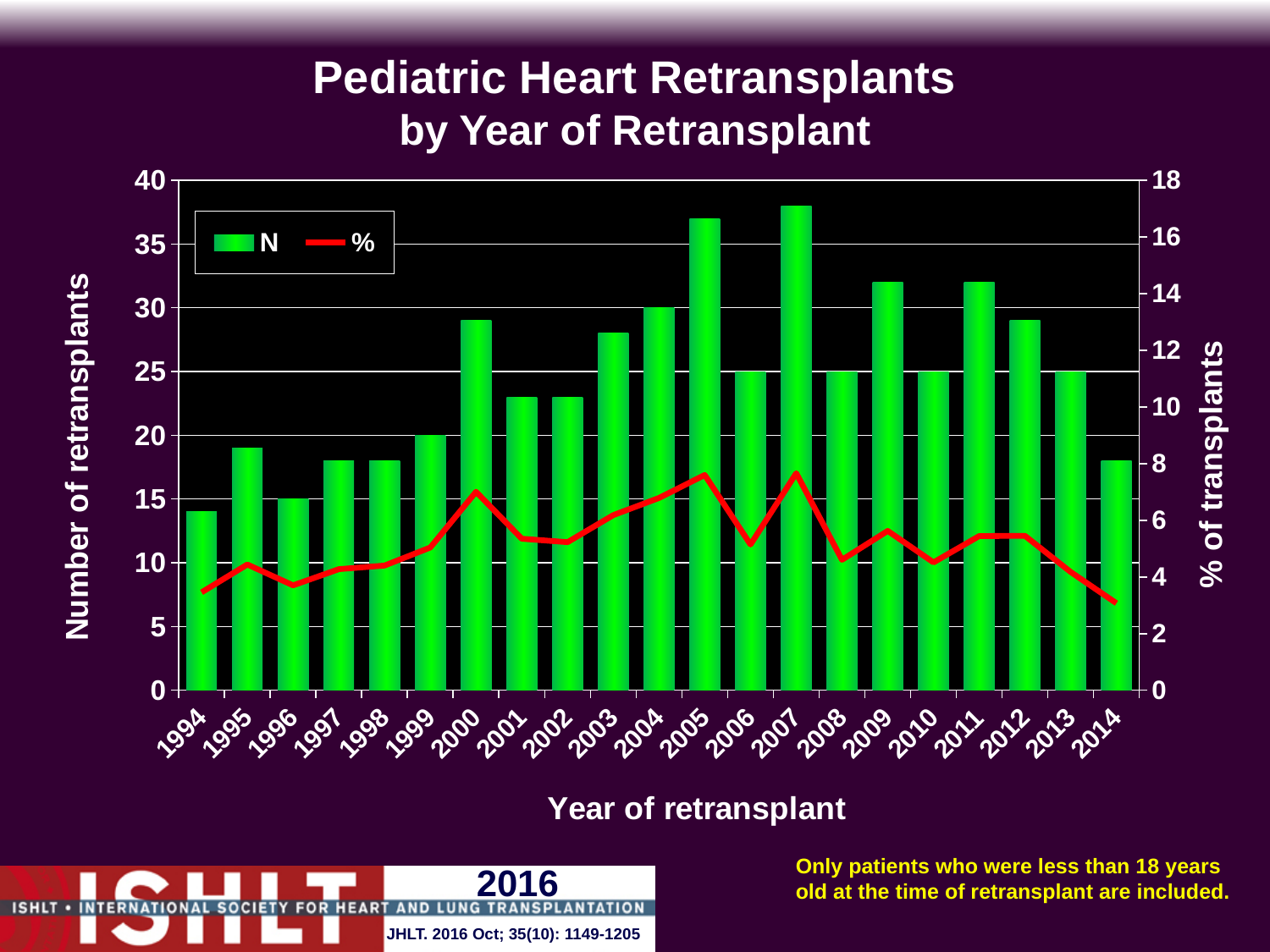
How many years are shown on the x axis of the chart? 21 What is the number of retransplants (N) for 1999? 20 How many series does the legend list? 2 Is the number of retransplants for 1994 greater or less than 15? less Which year has more retransplants, 2012 or 2014? 2012 Which year has more retransplants, 2005 or 2000? 2005 What are the two entries listed in the chart's legend? N and % Is the number of retransplants for 2007 greater or less than 35? greater What kind of chart is shown on the slide? bar chart with a line Is the % of transplants for 2014 greater or less than 4? less What is the number of retransplants (N) for 2004? 30 What is the number of retransplants (N) for 2006? 25